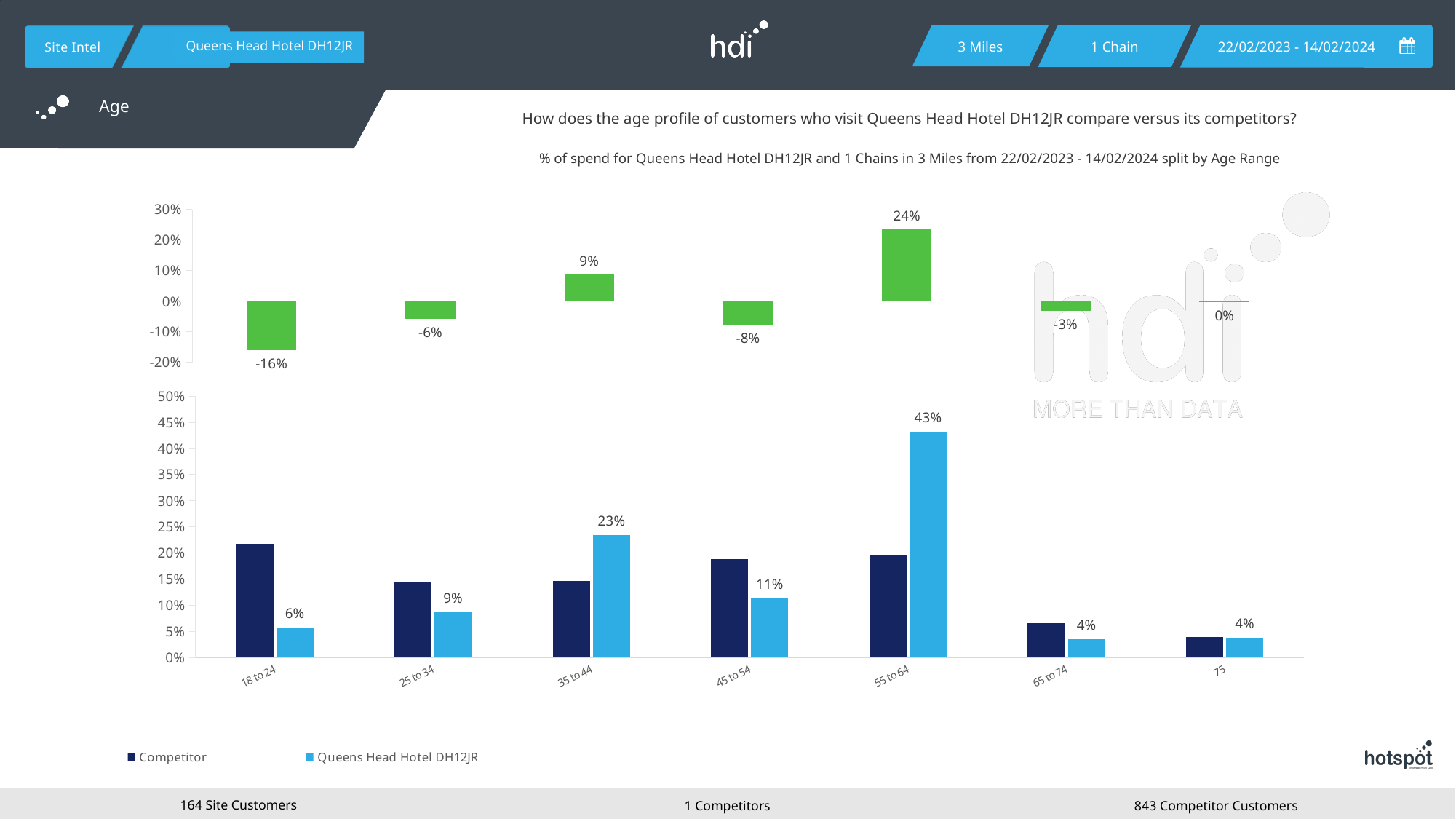
In the bottom chart, what is the value for Queens Head Hotel DH12JR in the 18 to 24 age range? 6% How many series does the legend of the bottom chart list? 2 In the bottom chart, what is the value for Queens Head Hotel DH12JR in the 55 to 64 age range? 43% In the bottom chart, is the Competitor value for 18 to 24 greater or less than 20%? greater In the bottom chart, which is larger for the 45 to 54 age range: the Competitor bar or the Queens Head Hotel DH12JR bar? Competitor In the bottom chart, which age range has the highest value for Queens Head Hotel DH12JR? 55 to 64 In the top chart, what is the value shown for the 18 to 24 age range? -16% In the top chart, which age range has the lowest value? 18 to 24 How many age range categories are shown on the x axis of the bottom chart? 7 In the bottom chart, what is the difference between the Queens Head Hotel DH12JR values for 55 to 64 and 35 to 44? 20% In the top chart, what is the value shown for the 55 to 64 age range? 24% What kind of chart is the bottom chart? Bar chart